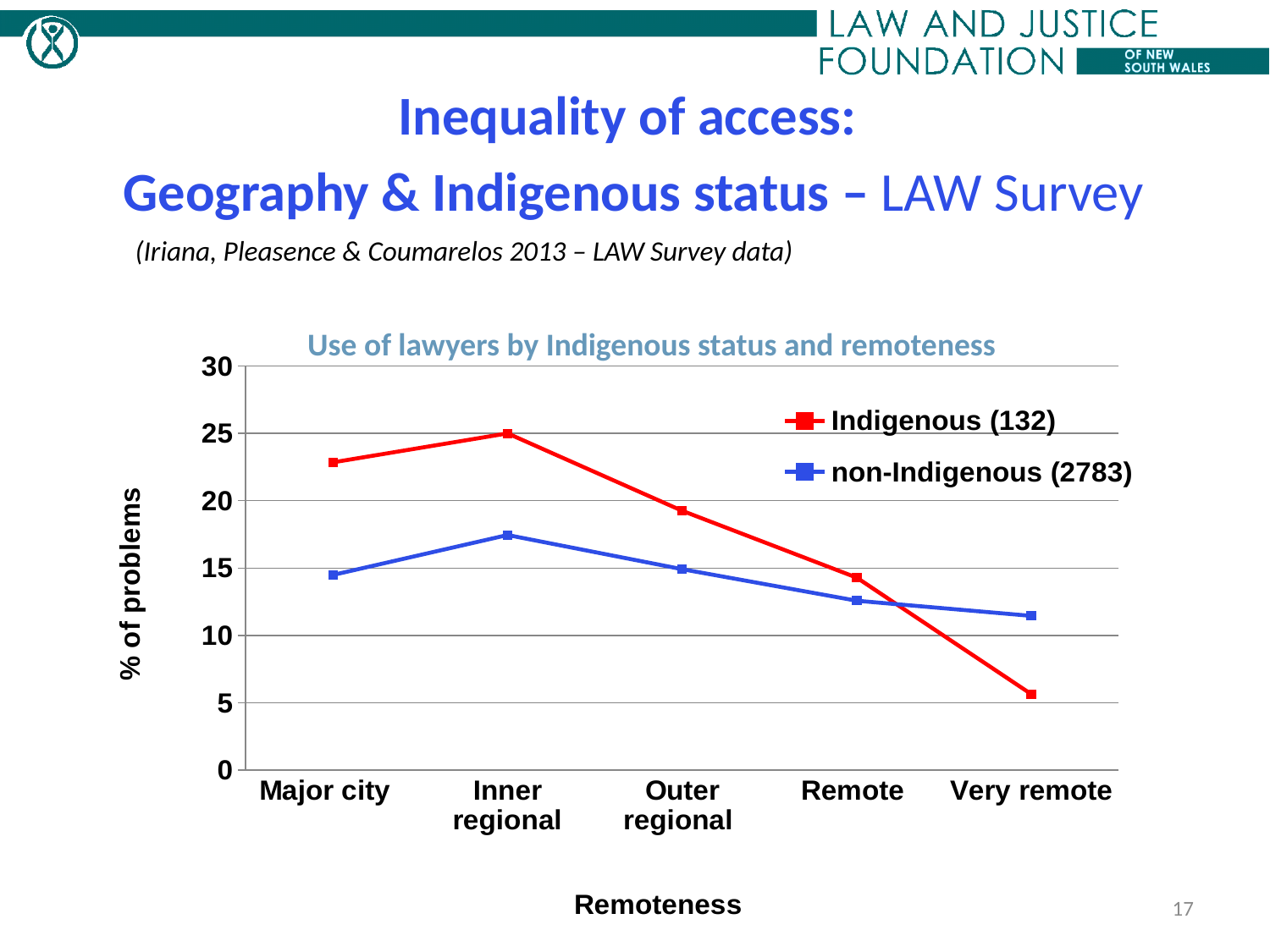
For the non-Indigenous series, which remoteness category has the highest value? Inner regional At Very remote, which series has the larger value, Indigenous or non-Indigenous? non-Indigenous How many series does the legend list? 2 For the Indigenous series, which remoteness category has the lowest value? Very remote How many remoteness categories are shown on the x axis? 5 For the Indigenous series, which remoteness category has the highest value? Inner regional At Major city, which series has the larger value, Indigenous or non-Indigenous? Indigenous Is the Indigenous value for Very remote greater or less than 10? less What is the title of the chart? Use of lawyers by Indigenous status and remoteness For the non-Indigenous series, which remoteness category has the lowest value? Very remote Is the Indigenous value for Major city greater or less than 20? greater What kind of chart is shown on the slide? line chart